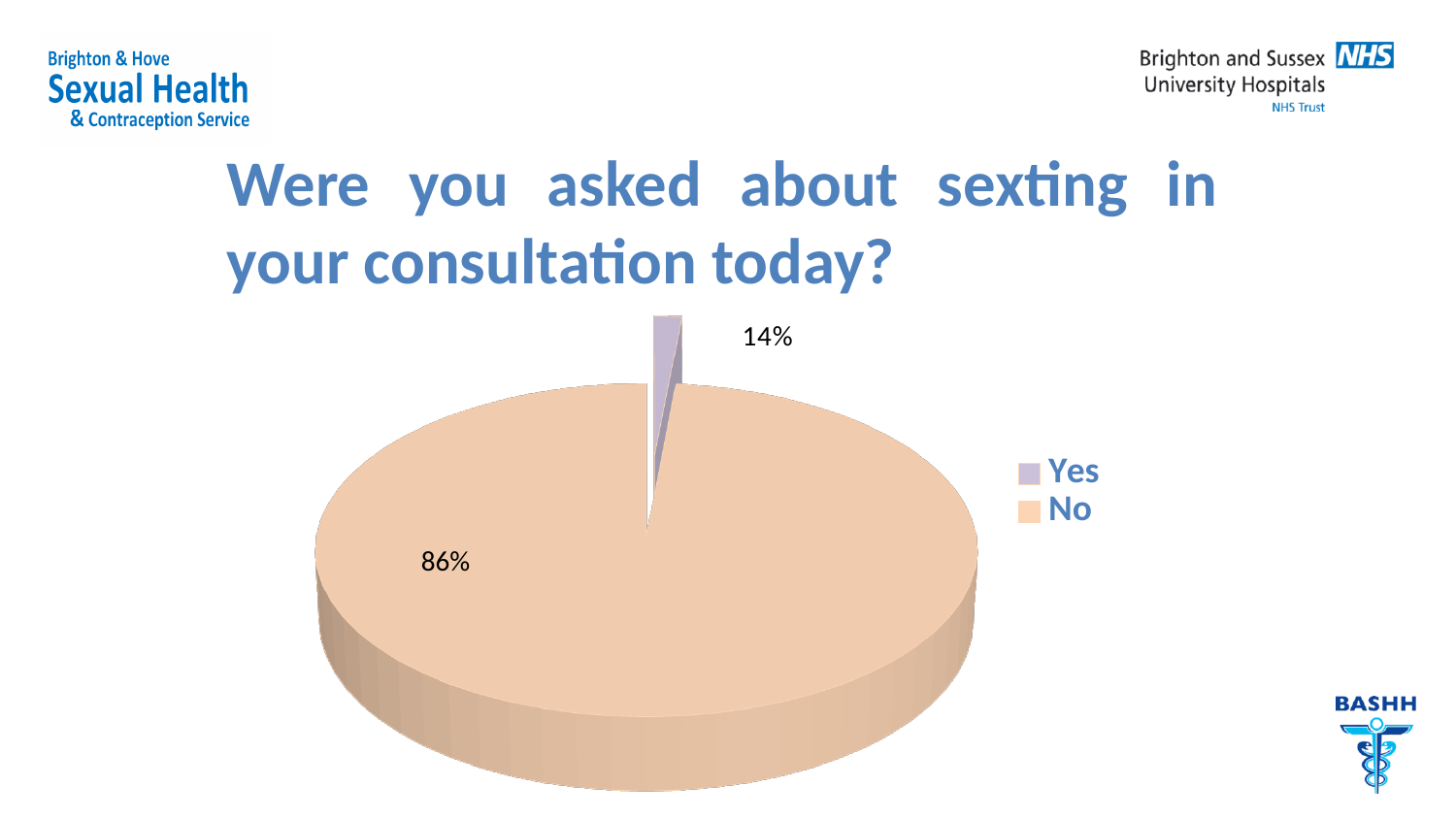
What question does the chart title ask? Were you asked about sexting in your consultation today? What is the difference in percentage points between the "No" and "Yes" responses? 72 Which response has the largest share of the pie? No What are the two entries listed in the legend? Yes and No Which response has the smallest share of the pie? Yes Which is larger, the share for "Yes" or the share for "No"? No What percentage of respondents answered "Yes"? 14% What share of the pie does the "No" slice represent? 86% What percentage of respondents answered "No"? 86% What kind of chart is shown on the slide? Pie chart How many categories does the pie chart show? 2